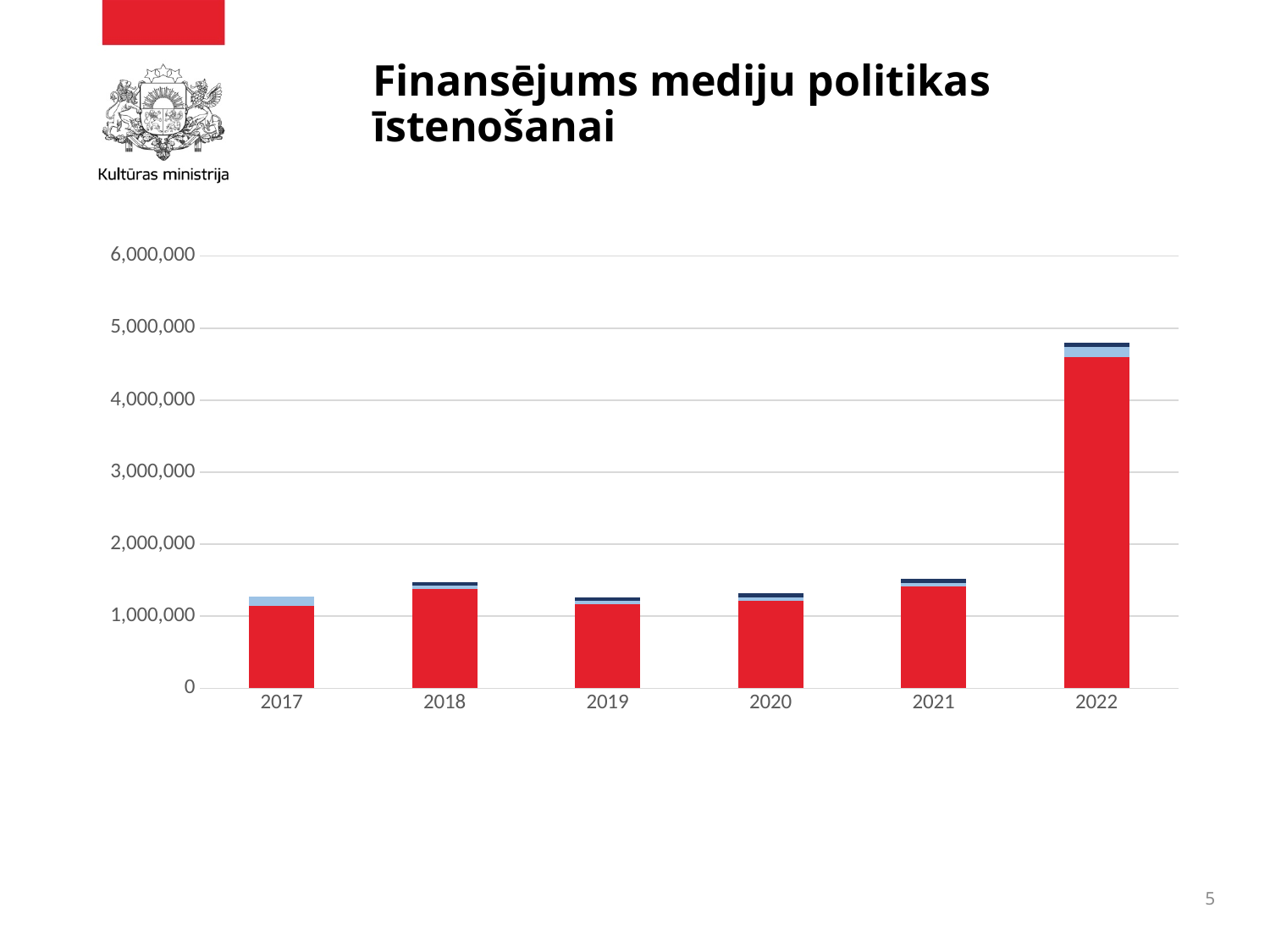
What kind of chart is shown on the slide? bar chart What is the title of the slide containing the chart? Finansējums mediju politikas īstenošanai Which bar is taller, 2021 or 2022? 2022 Which bar is taller, 2019 or 2021? 2021 Which bar is taller, 2017 or 2018? 2018 Is the total value for 2018 greater or less than 2,000,000? less Is the total value for 2022 greater or less than 4,000,000? greater Does the total value rise or fall from 2021 to 2022? rise Is the total value for 2022 greater or less than 5,000,000? less Which year has the highest bar in the chart? 2022 How many years are shown on the x axis of the chart? 6